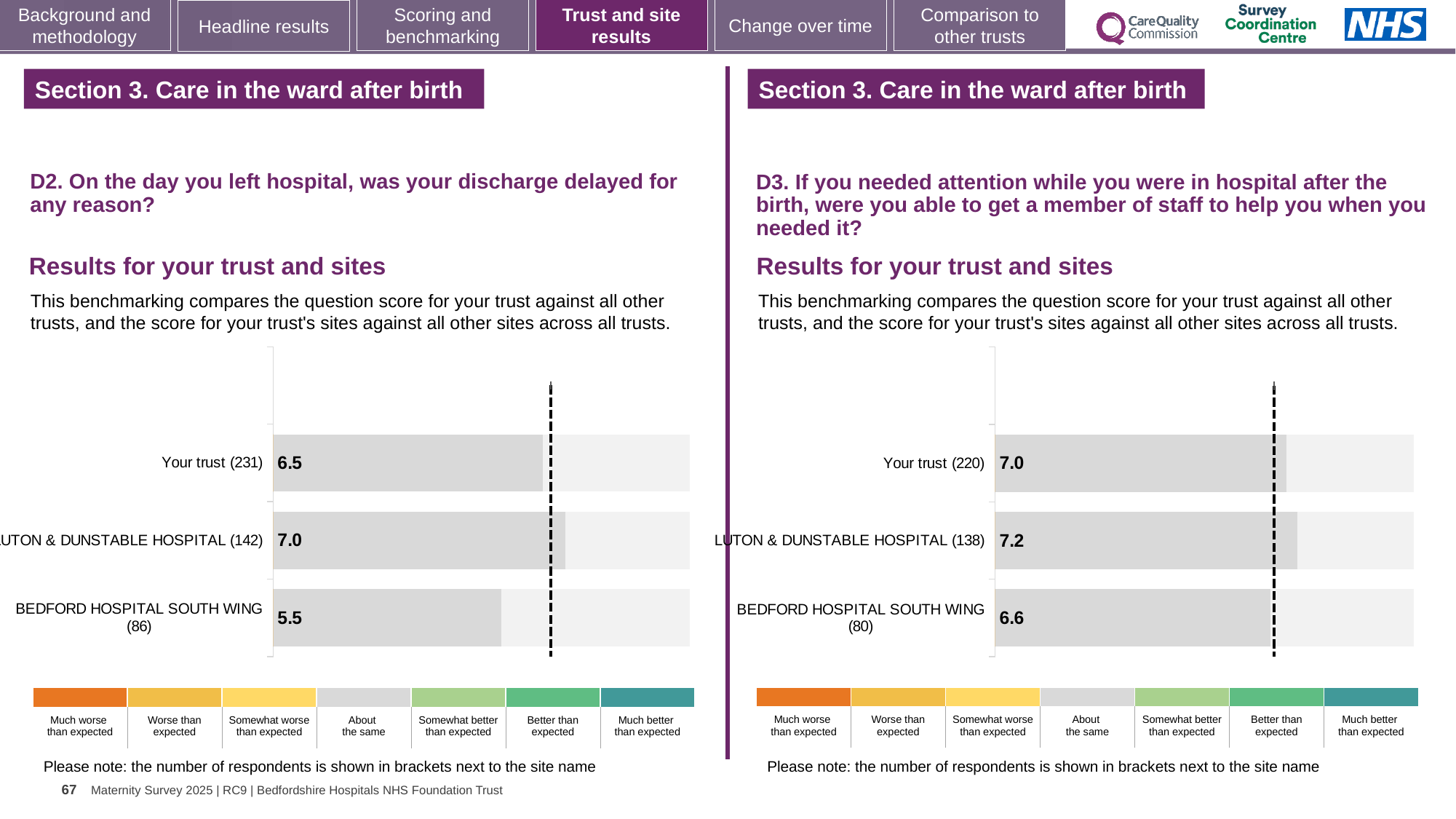
What kind of chart is used on the D3 chart (right)? bar chart On the D3 chart (right), is the score for Your trust larger or smaller than the score for Luton & Dunstable Hospital? smaller On the D3 chart (right), what is the difference between the Your trust score and the Bedford Hospital South Wing score? 0.4 On the D2 chart (left), what is the score for Your trust? 6.5 How many bars are plotted on the D2 chart (left)? 3 On the D3 chart (right), what is the score for Bedford Hospital South Wing? 6.6 On the D3 chart (right), what is the score for Luton & Dunstable Hospital? 7.2 On the D2 chart (left), what is the score for Bedford Hospital South Wing? 5.5 On the D3 chart (right), which site or trust has the lowest score? Bedford Hospital South Wing On the D2 chart (left), which site or trust has the highest score? Luton & Dunstable Hospital On the D2 chart (left), what is the difference between the Luton & Dunstable Hospital score and the Bedford Hospital South Wing score? 1.5 On the D2 chart (left), how many respondents are shown for Your trust? 231